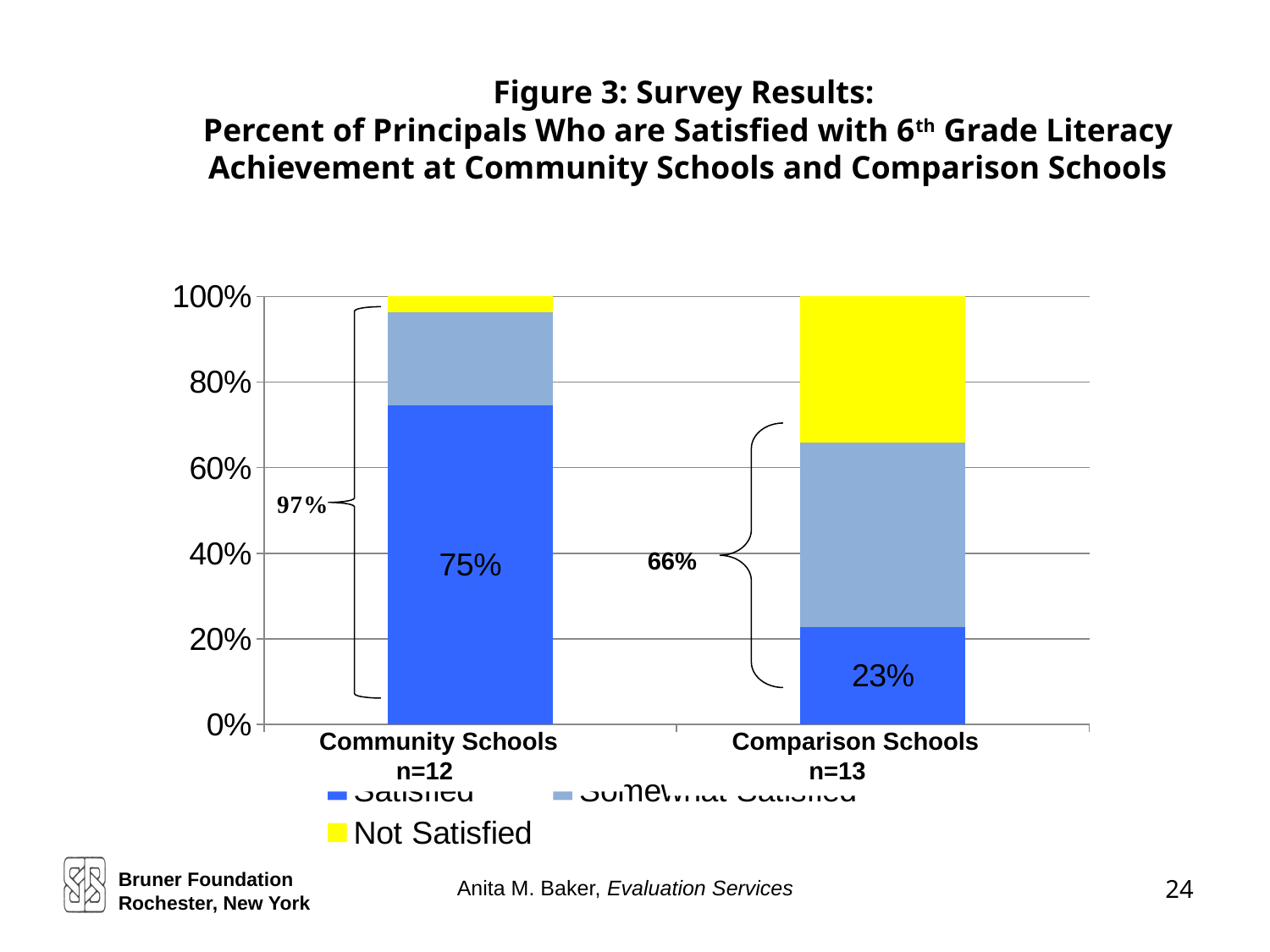
How many series does the legend list? 3 What kind of chart is shown on the slide? Stacked bar chart Is the Somewhat Satisfied share for Community Schools greater or less than 40%? less What percentage of principals at Comparison Schools are Satisfied? 23% What percentage of principals at Community Schools are Satisfied? 75% What combined percentage is marked by the brace next to the Community Schools bar? 97% What is the difference in percentage points between the Satisfied share at Community Schools and at Comparison Schools? 52 percentage points Which group has the larger Satisfied percentage, Community Schools or Comparison Schools? Community Schools What is the sample size (n) shown for Community Schools? n=12 How many school groups (categories) are shown on the x axis? 2 What combined percentage is marked by the brace next to the Comparison Schools bar? 66% Is the Not Satisfied share for Comparison Schools greater or less than 20%? greater